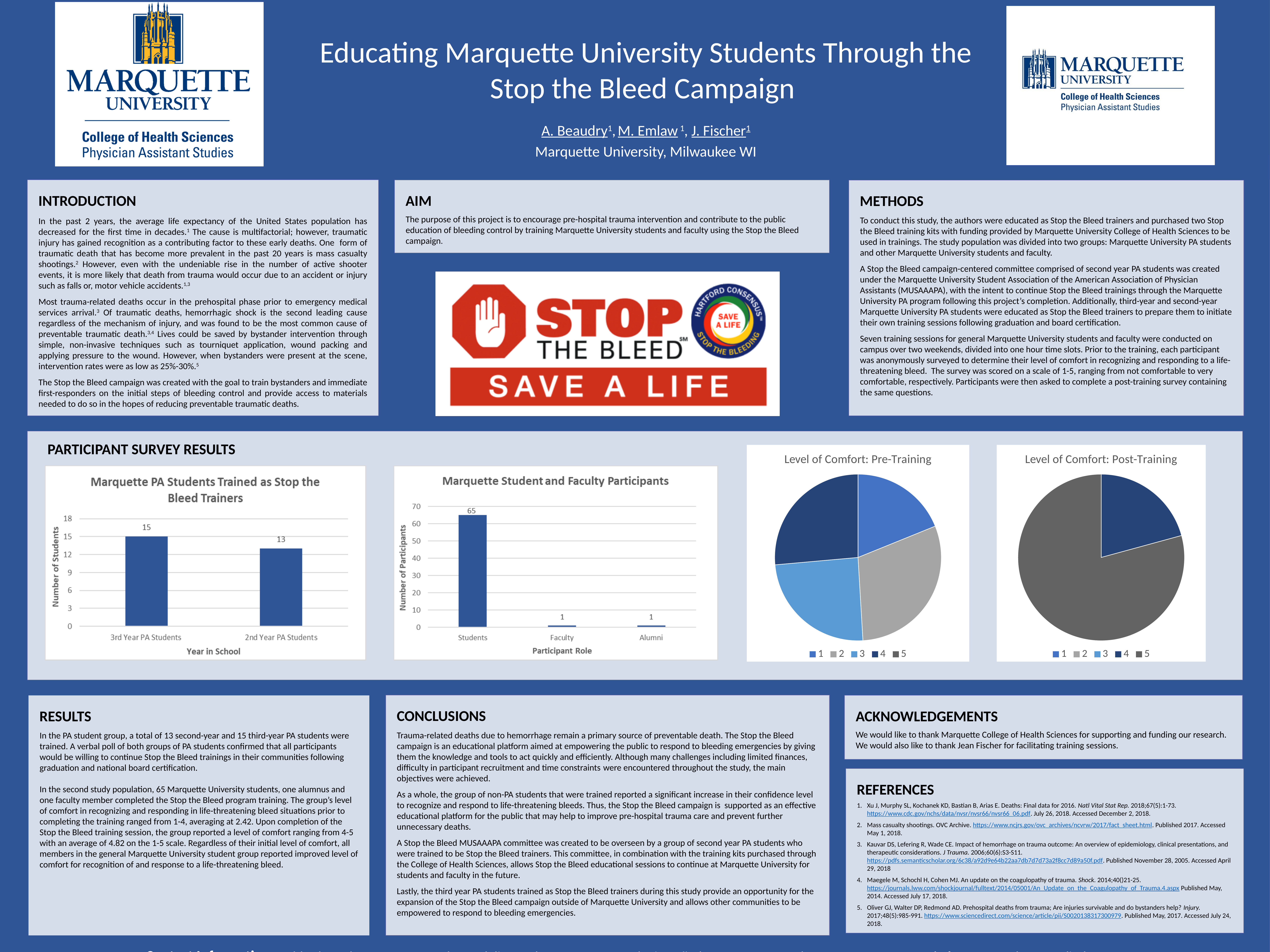
In the chart 'Marquette PA Students Trained as Stop the Bleed Trainers', what is the difference between the 3rd Year and 2nd Year PA Students values? 2 In the chart 'Marquette PA Students Trained as Stop the Bleed Trainers', how many 2nd Year PA Students were trained? 13 In the chart 'Marquette Student and Faculty Participants', what is the difference between the Students and Alumni values? 64 What is the label of the y axis in the chart 'Marquette Student and Faculty Participants'? Number of Participants In the chart 'Marquette Student and Faculty Participants', how many participants were Faculty? 1 In the chart 'Marquette PA Students Trained as Stop the Bleed Trainers', which category has the higher value? 3rd Year PA Students In the chart 'Marquette Student and Faculty Participants', how many participants were Students? 65 In the pie chart 'Level of Comfort: Post-Training', which comfort level has the largest slice? 5 In the chart 'Marquette PA Students Trained as Stop the Bleed Trainers', how many 3rd Year PA Students were trained? 15 In the chart 'Marquette Student and Faculty Participants', how many participant roles are shown on the x axis? 3 How many entries does the legend of the pie chart 'Level of Comfort: Pre-Training' list? 5 What type of chart is 'Marquette Student and Faculty Participants'? Bar chart